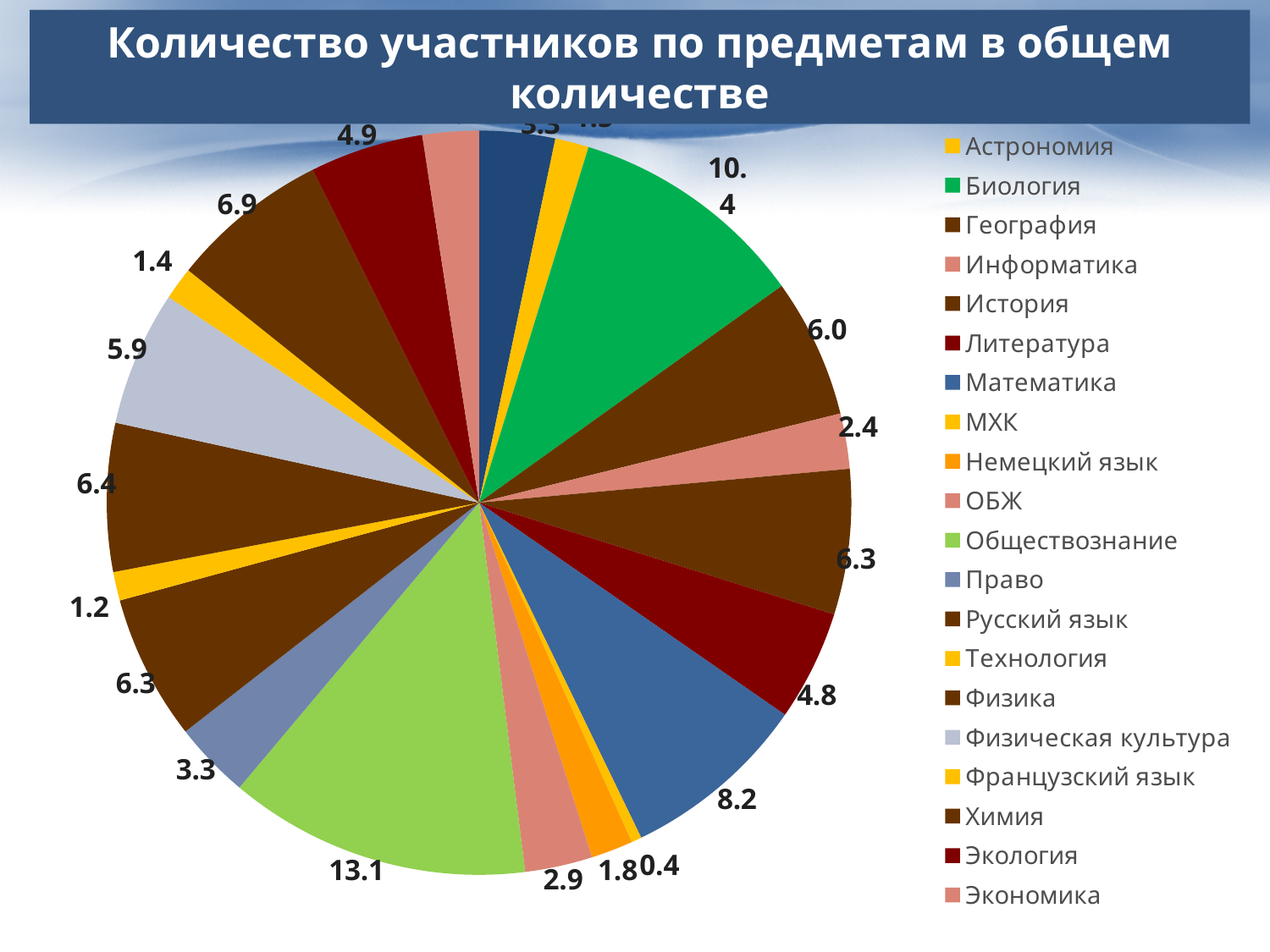
What is the value shown for Математика? 8.2 What is the difference between the values for Обществознание and Математика? 4.9 What kind of chart is shown on the slide? pie chart Which is larger, the value for Биология or the value for Математика? Биология Which subject has the smallest labelled slice of the pie? МХК What is the value shown for МХК? 0.4 What is the value shown for Биология? 10.4 What is the value shown for Обществознание? 13.1 Which subject has the largest slice of the pie? Обществознание What is the value shown for Химия? 6.9 What is the title of the chart? Количество участников по предметам в общем количестве How many entries does the legend list? 20